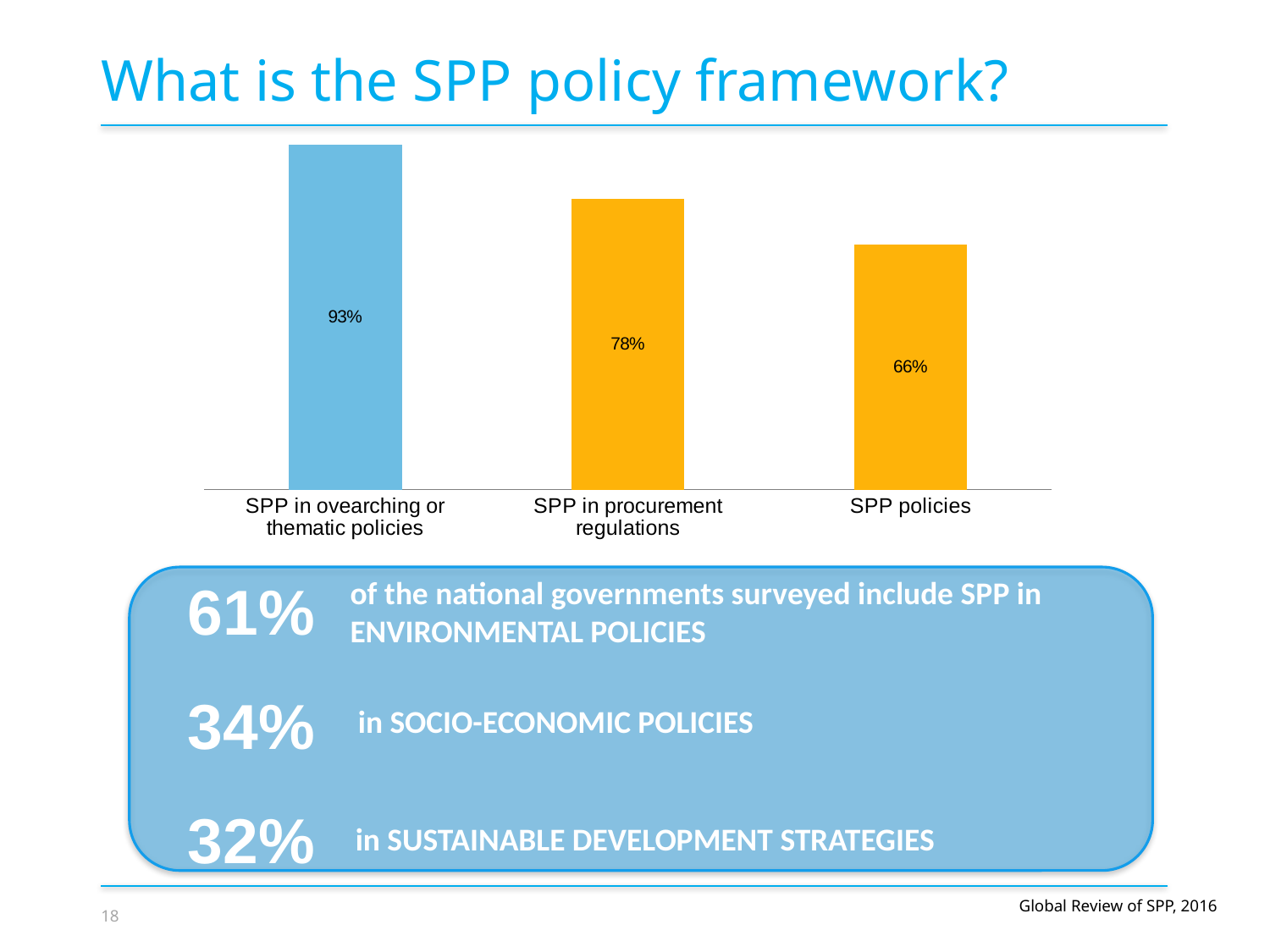
Which category has the highest value? SPP in ovearching or thematic policies What is the value for SPP policies? 66% How many categories are shown in the chart? 3 What is the difference between the values for SPP in ovearching or thematic policies and SPP policies? 27% What kind of chart is shown on the slide? Bar chart What is the value for SPP in procurement regulations? 78% Which is larger, the value for SPP in procurement regulations or the value for SPP policies? SPP in procurement regulations What is the value for SPP in ovearching or thematic policies? 93% What colour is the bar for SPP in ovearching or thematic policies? Blue What is the difference between the values for SPP in procurement regulations and SPP policies? 12% Do the values rise or fall from left to right across the categories? Fall Which category has the lowest value? SPP policies